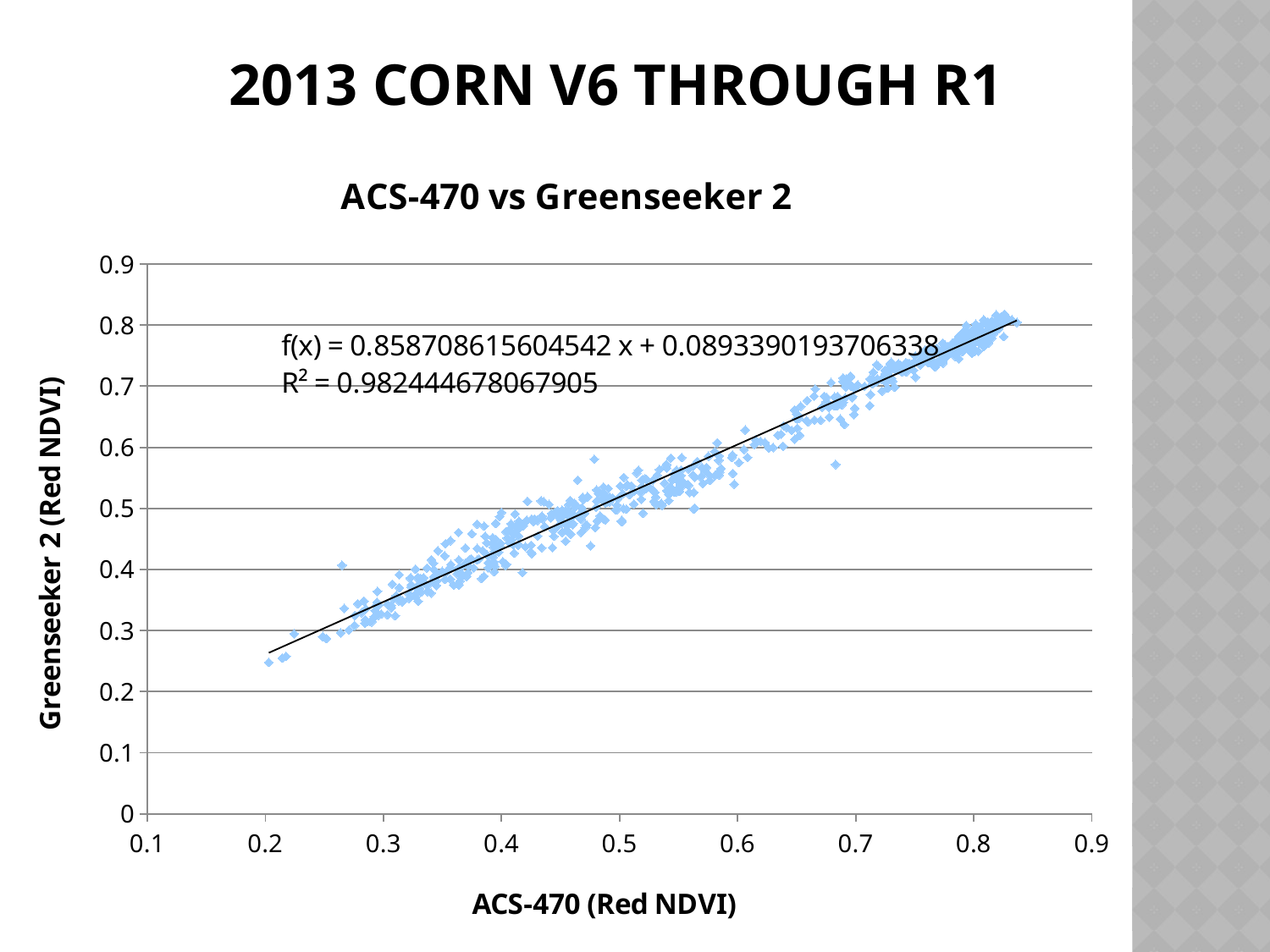
What is the lowest value shown on the x axis? 0.1 What is the intercept of the fitted line f(x) printed on the chart? 0.0893390193706338 Is the Greenseeker 2 value for points with ACS-470 around 0.5 greater or less than 0.6? less What is the slope of the fitted line f(x) printed on the chart? 0.858708615604542 Is the Greenseeker 2 value for points with ACS-470 around 0.2 greater or less than 0.3? less Do the Greenseeker 2 values rise or fall as ACS-470 increases along the x axis? rise What is the title of the chart? ACS-470 vs Greenseeker 2 What is the highest value shown on the y axis? 0.9 What R² value is printed on the chart for the trendline? 0.982444678067905 Is the Greenseeker 2 value for points with ACS-470 around 0.8 greater or less than 0.7? greater What is the label of the x axis? ACS-470 (Red NDVI) What kind of chart is shown on the slide? scatter plot